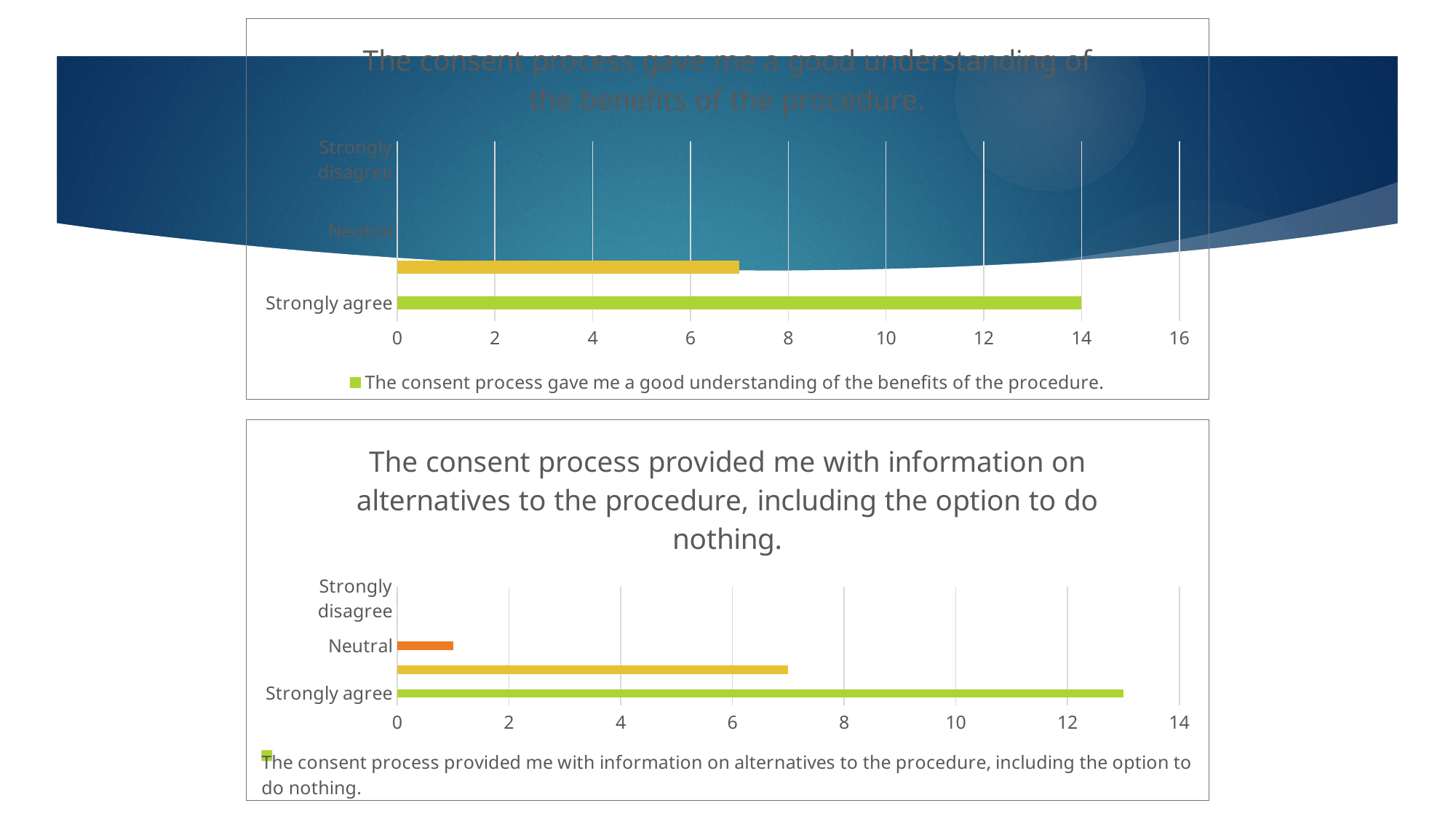
In the top chart, what is the value for Strongly agree? 14 In the bottom chart, titled "The consent process provided me with information on alternatives to the procedure, including the option to do nothing.", which category has the highest value? Strongly agree In the bottom chart, which is larger, the value for Strongly agree or the value for Neutral? Strongly agree What is the highest value shown on the horizontal axis of the bottom chart? 14 In the top chart, is the value of the bar directly above Strongly agree greater or less than 8? less In the bottom chart, is the value for Neutral greater or less than 2? less How many series does the legend of the top chart list? 1 In the top chart, which category has the highest value? Strongly agree In the top chart, is the value of the bar directly above Strongly agree greater or less than 6? greater What kind of chart is the top chart, titled "The consent process gave me a good understanding of the benefits of the procedure."? bar chart What is the highest value shown on the horizontal axis of the top chart? 16